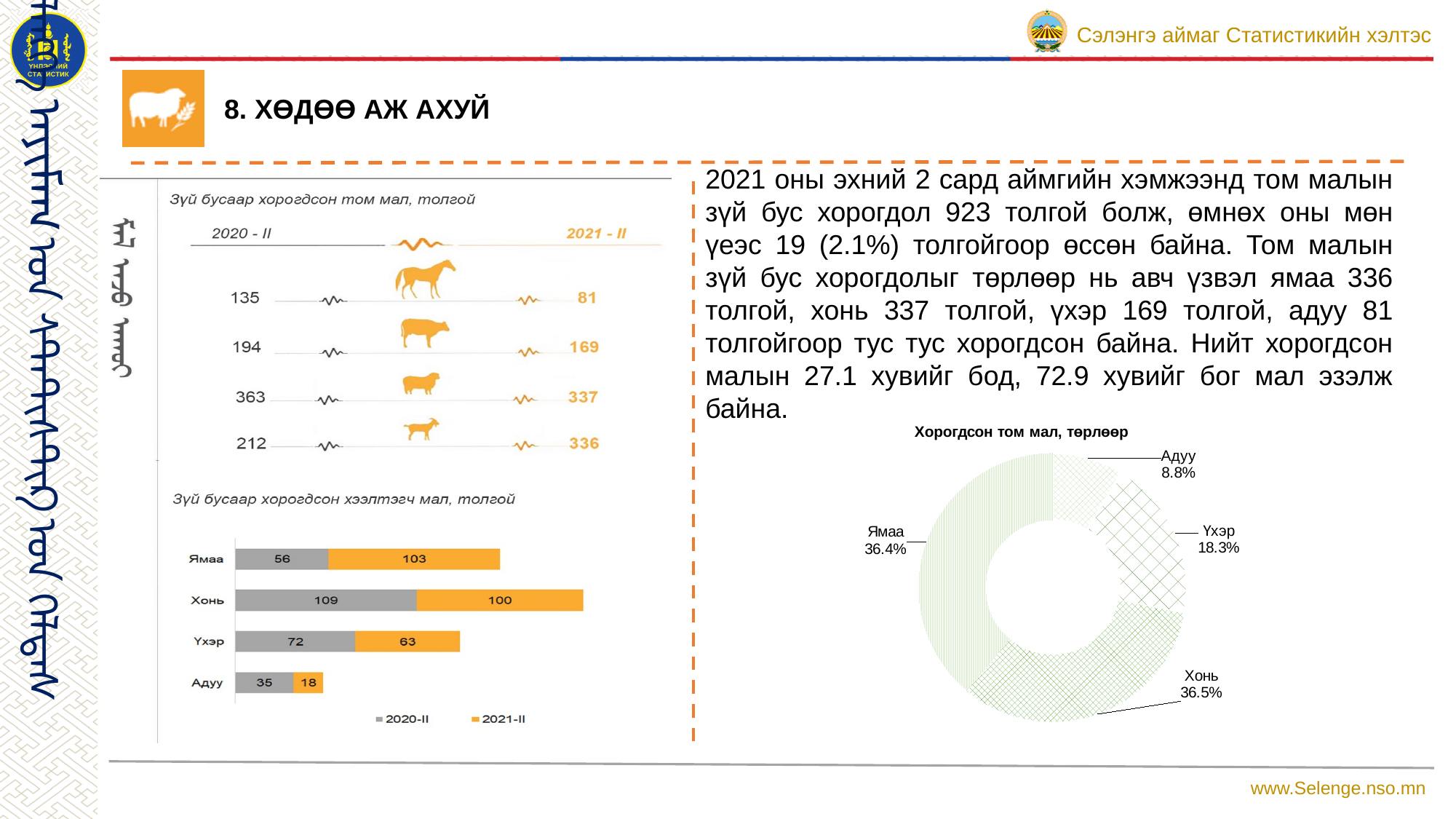
In the chart 'Зүй бусаар хорогдсон хээлтэгч мал, толгой', how many series does the legend list? 2 In the chart 'Зүй бусаар хорогдсон хээлтэгч мал, толгой', what is the 2021-II value for Ямаа? 103 In the chart 'Зүй бусаар хорогдсон хээлтэгч мал, толгой', what is the total of the stacked bar for Үхэр? 135 What kind of chart is 'Зүй бусаар хорогдсон хээлтэгч мал, толгой'? Stacked bar chart How many categories are shown in the chart 'Хорогдсон том мал, төрлөөр'? 4 In the chart 'Зүй бусаар хорогдсон хээлтэгч мал, толгой', which category has the lowest 2021-II value? Адуу In the chart 'Зүй бусаар хорогдсон хээлтэгч мал, толгой', what is the 2020-II value for Хонь? 109 In the chart 'Зүй бусаар хорогдсон том мал, толгой', what is the 2021-II value in the row with the horse icon? 81 In the chart 'Хорогдсон том мал, төрлөөр', which category has the smallest share? Адуу In the chart 'Зүй бусаар хорогдсон хээлтэгч мал, толгой', what is the difference between the 2020-II and 2021-II values for Адуу? 17 In the chart 'Хорогдсон том мал, төрлөөр', what share does Үхэр have? 18.3% In the chart 'Зүй бусаар хорогдсон том мал, толгой', what is the 2020-II value in the row with the sheep icon? 363